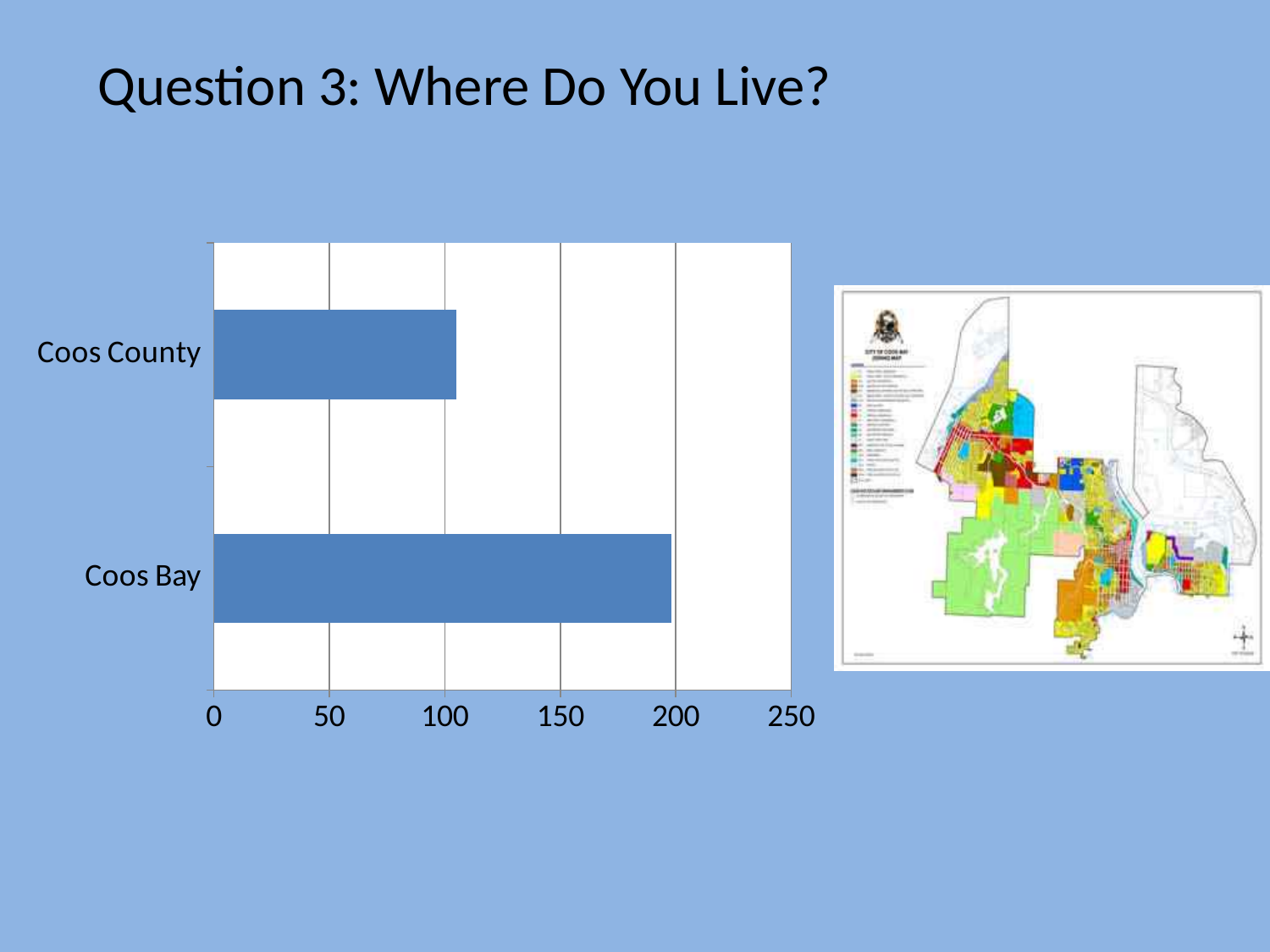
Which is larger, the value for Coos Bay or the value for Coos County? Coos Bay What kind of chart is shown on the slide? bar chart Which category has the highest value in the bar chart? Coos Bay What is the title of the slide containing the bar chart? Question 3: Where Do You Live? How many categories does the bar chart show? 2 Which category has the lowest value in the bar chart? Coos County Is the value for Coos County greater or less than 150? less Is the value for Coos Bay greater or less than 250? less Is the value for Coos Bay greater or less than 150? greater What is the maximum value shown on the horizontal axis of the bar chart? 250